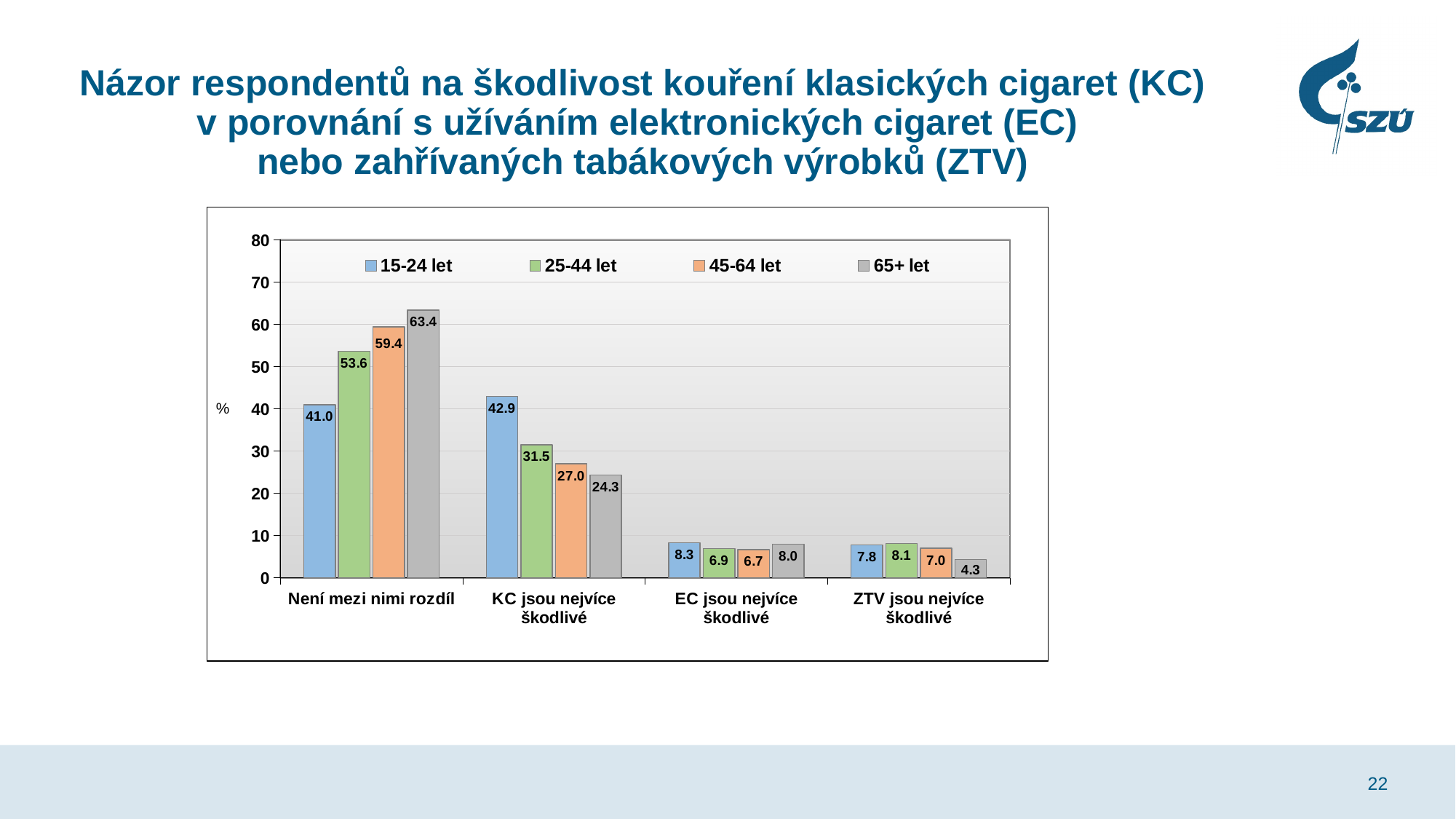
What is the value for the 65+ let series in the 'Není mezi nimi rozdíl' category? 63.4 What is the value for the 15-24 let series in the 'KC jsou nejvíce škodlivé' category? 42.9 In the 'KC jsou nejvíce škodlivé' category, which is larger: the 25-44 let value or the 45-64 let value? 25-44 let What kind of chart is shown on the slide? bar chart What is the value for the 45-64 let series in the 'EC jsou nejvíce škodlivé' category? 6.7 Which age group has the highest value in the 'Není mezi nimi rozdíl' category? 65+ let Across the age groups from 15-24 let to 65+ let, do the values in the 'KC jsou nejvíce škodlivé' category rise or fall? fall How many categories are shown on the x axis? 4 How many series does the legend list? 4 What is the difference between the 45-64 let and 15-24 let values in the 'Není mezi nimi rozdíl' category? 18.4 Which age group has the lowest value in the 'ZTV jsou nejvíce škodlivé' category? 65+ let What unit is shown on the y axis label? %